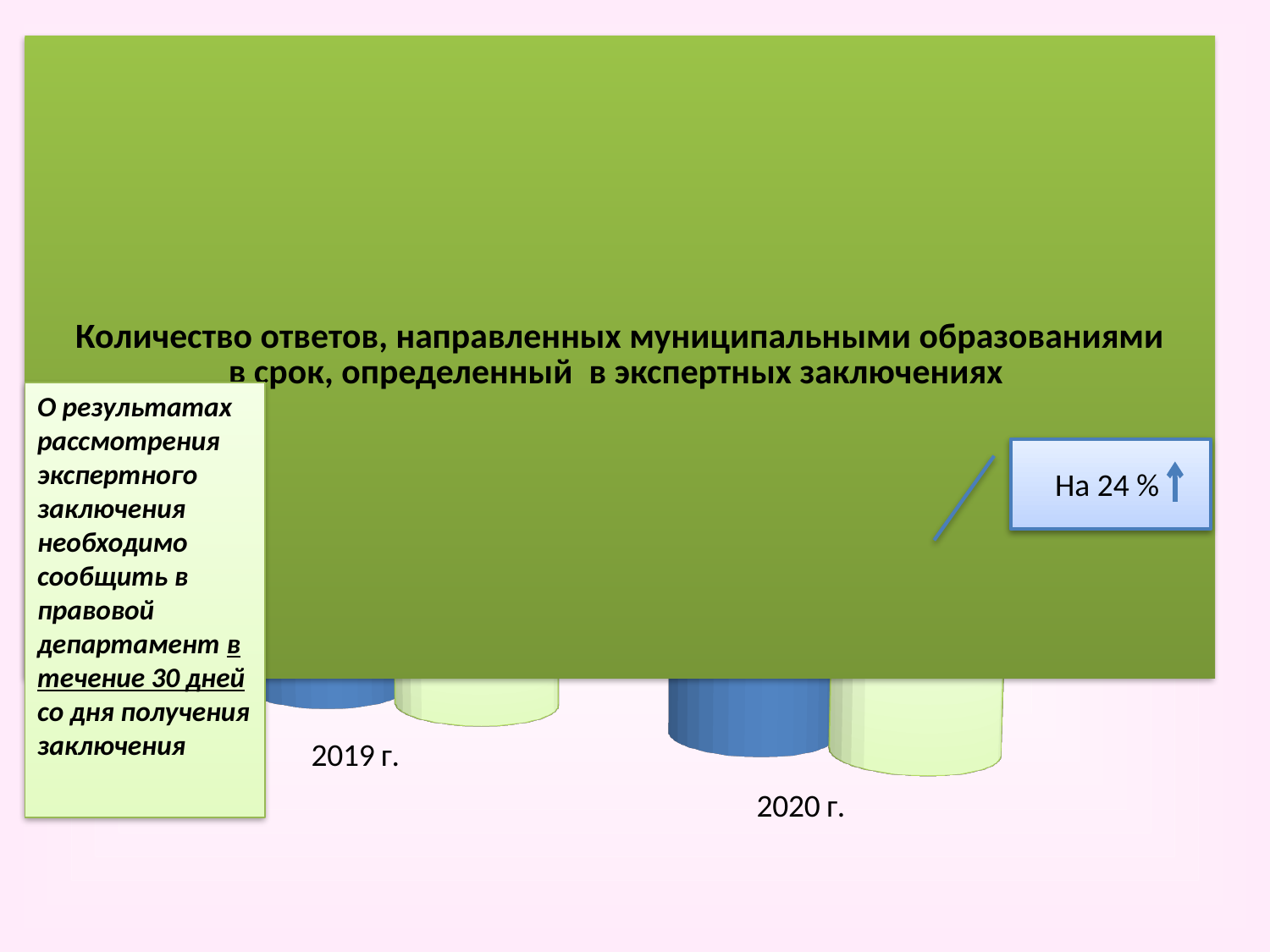
What is the title of the chart? Количество ответов, направленных муниципальными образованиями в срок, определенный в экспертных заключениях Do the values rise or fall from 2019 г. to 2020 г.? rise What kind of chart is shown on the slide? bar chart How many categories (years) are shown on the x axis of the chart? 2 By what percentage does the callout on the chart say the value changed? На 24 % Which years are shown as categories on the chart? 2019 г. and 2020 г. How many bars are plotted for each year on the chart? 2